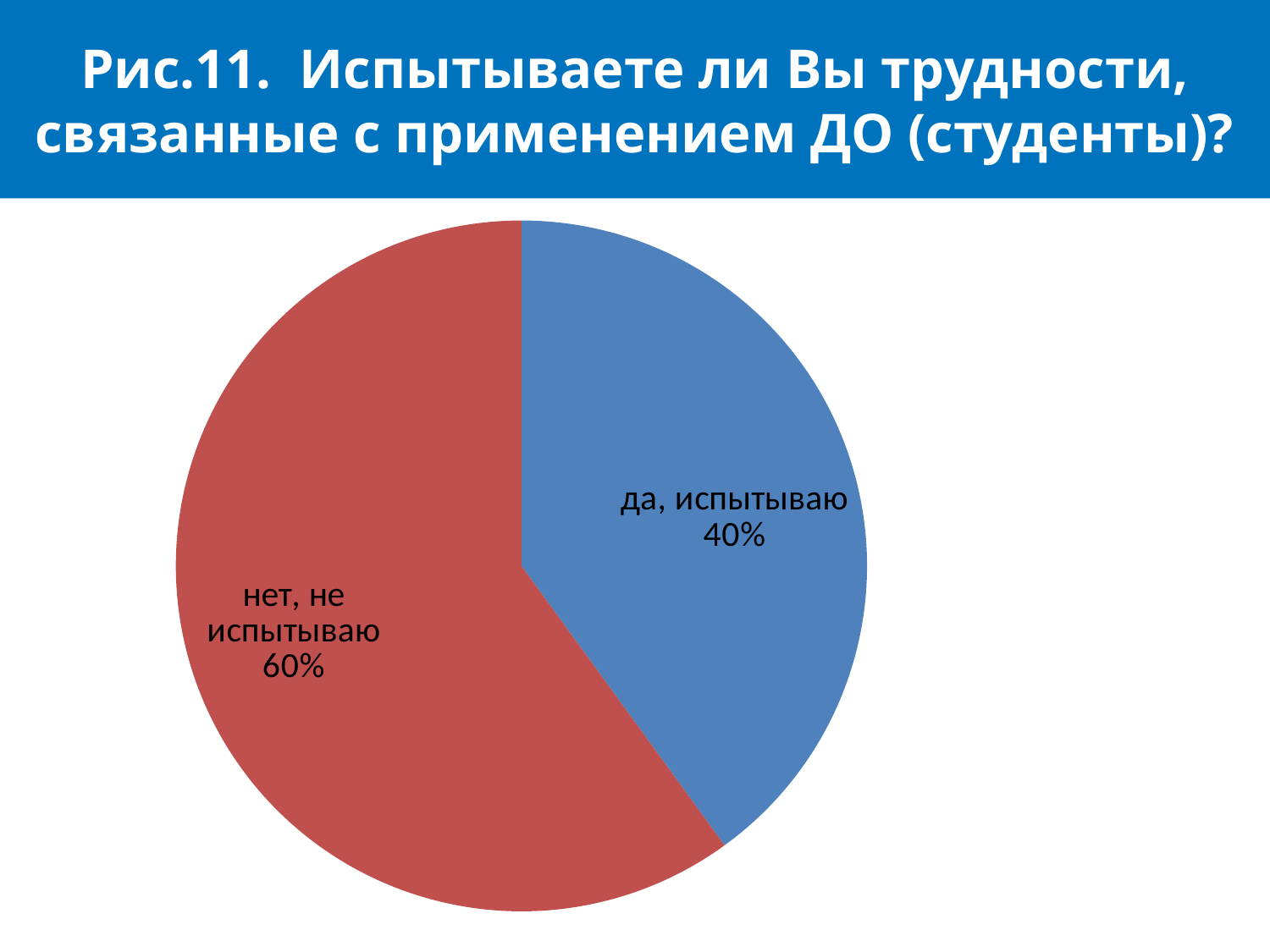
What is the difference in percentage points between "нет, не испытываю" and "да, испытываю"? 20% Which slice is the largest? нет, не испытываю What kind of chart is shown on the slide? pie chart How many slices does the pie chart have? 2 Which is larger: the share for "да, испытываю" or the share for "нет, не испытываю"? нет, не испытываю What colour is the slice for "да, испытываю"? blue Which slice is the smallest? да, испытываю What share of the pie is labelled "да, испытываю"? 40% What share of the pie is labelled "нет, не испытываю"? 60% What is the title of the chart? Рис.11. Испытываете ли Вы трудности, связанные с применением ДО (студенты)?